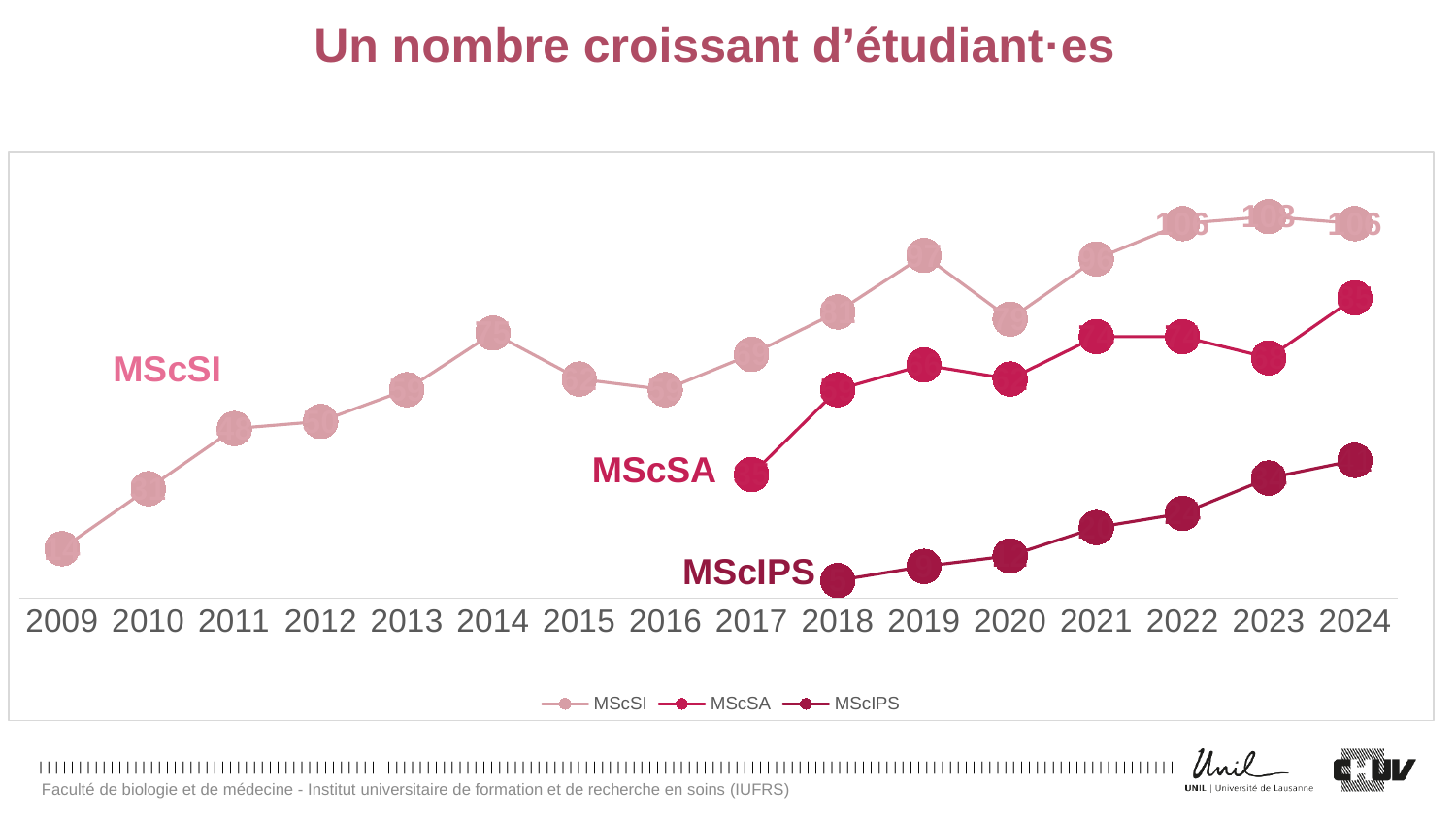
Which series has the higher value in 2024, MScSI or MScIPS? MScSI What is the title of the slide? Un nombre croissant d'étudiant·es In which year is the MScSA value highest? 2024 How many series does the legend list? 3 Which series has data starting in 2009? MScSI How many years are shown on the x axis? 16 In which year is the MScIPS value highest? 2024 In which year does the MScSA series first appear? 2017 What kind of chart is shown on the slide? line chart In which year is the MScSI value lowest? 2009 Does the MScIPS series rise or fall from 2018 to 2024? rise In which year does the MScIPS series first appear? 2018